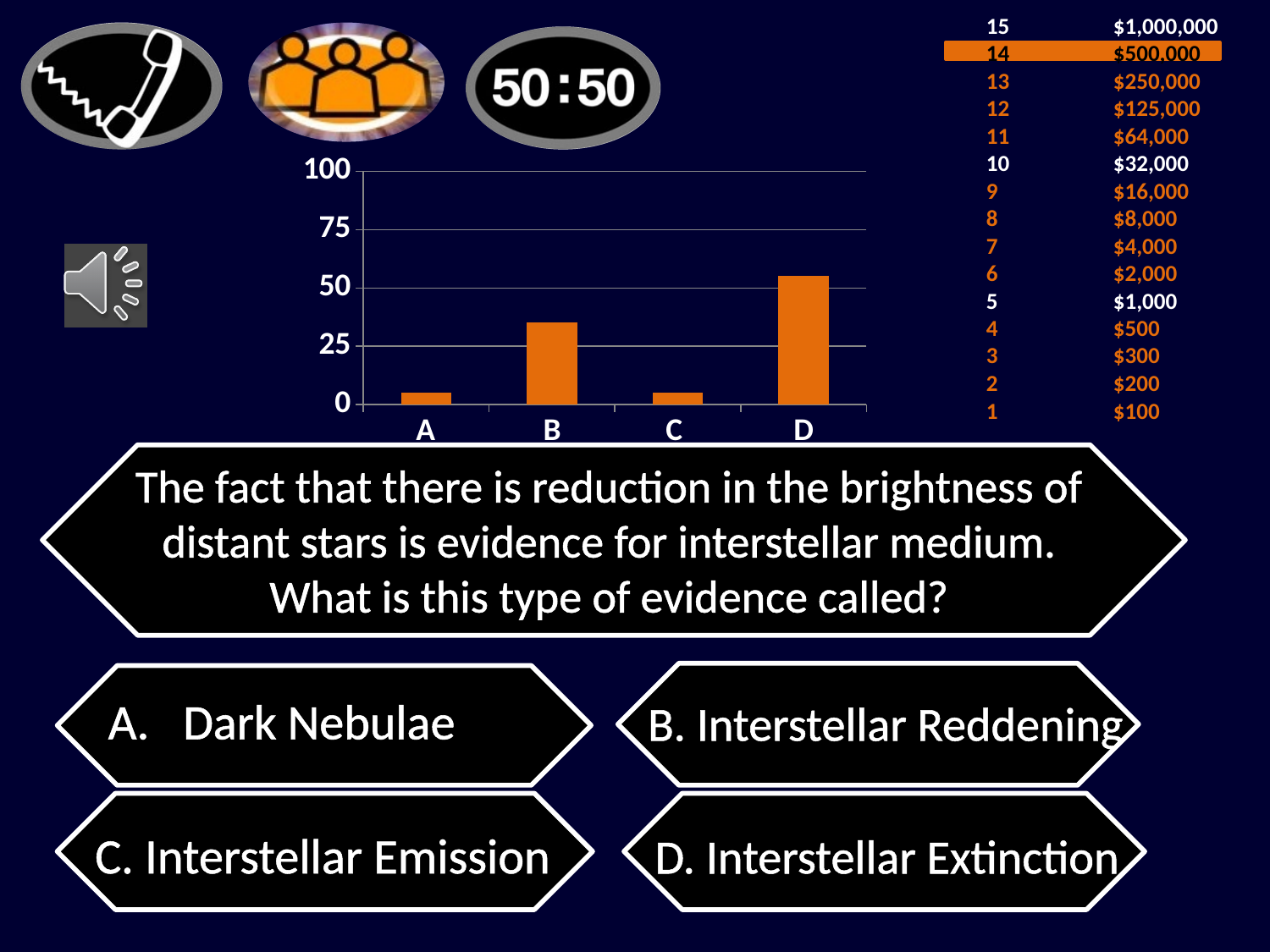
Which is larger, the value for A or the value for B? B Which category has the highest bar in the chart? D Is the value for D greater or less than 25? greater Is the value for B greater or less than 25? greater Is the value for A greater or less than 25? less What kind of chart is shown on the slide? bar chart What is the highest tick value shown on the y axis of the chart? 100 How many categories are shown on the x axis of the bar chart? 4 Which is larger, the value for B or the value for D? D